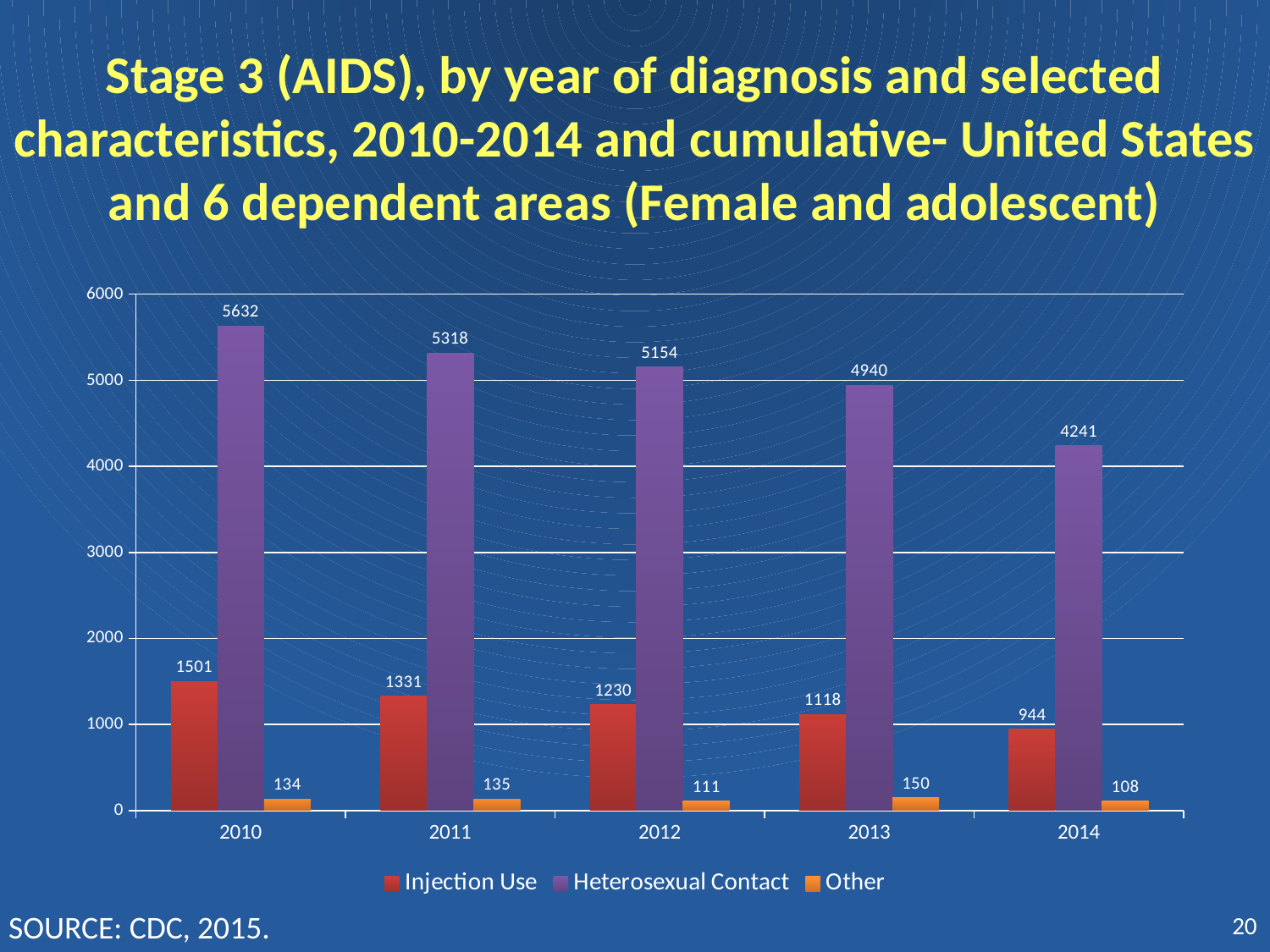
What is the value for Other in 2013? 150 What is the difference between the Heterosexual Contact values for 2010 and 2014? 1391 What is the difference between Injection Use and Other in 2012? 1119 What kind of chart is shown on the slide? Bar chart In which year is the Heterosexual Contact value lowest? 2014 In which year is the Other value highest? 2013 How many years are shown on the x axis? 5 What is the value for Heterosexual Contact in 2010? 5632 Which is larger, the Injection Use value in 2011 or in 2013? 2011 What is the value for Injection Use in 2014? 944 Do the Injection Use values rise or fall from 2010 to 2014? Fall How many series does the legend list? 3